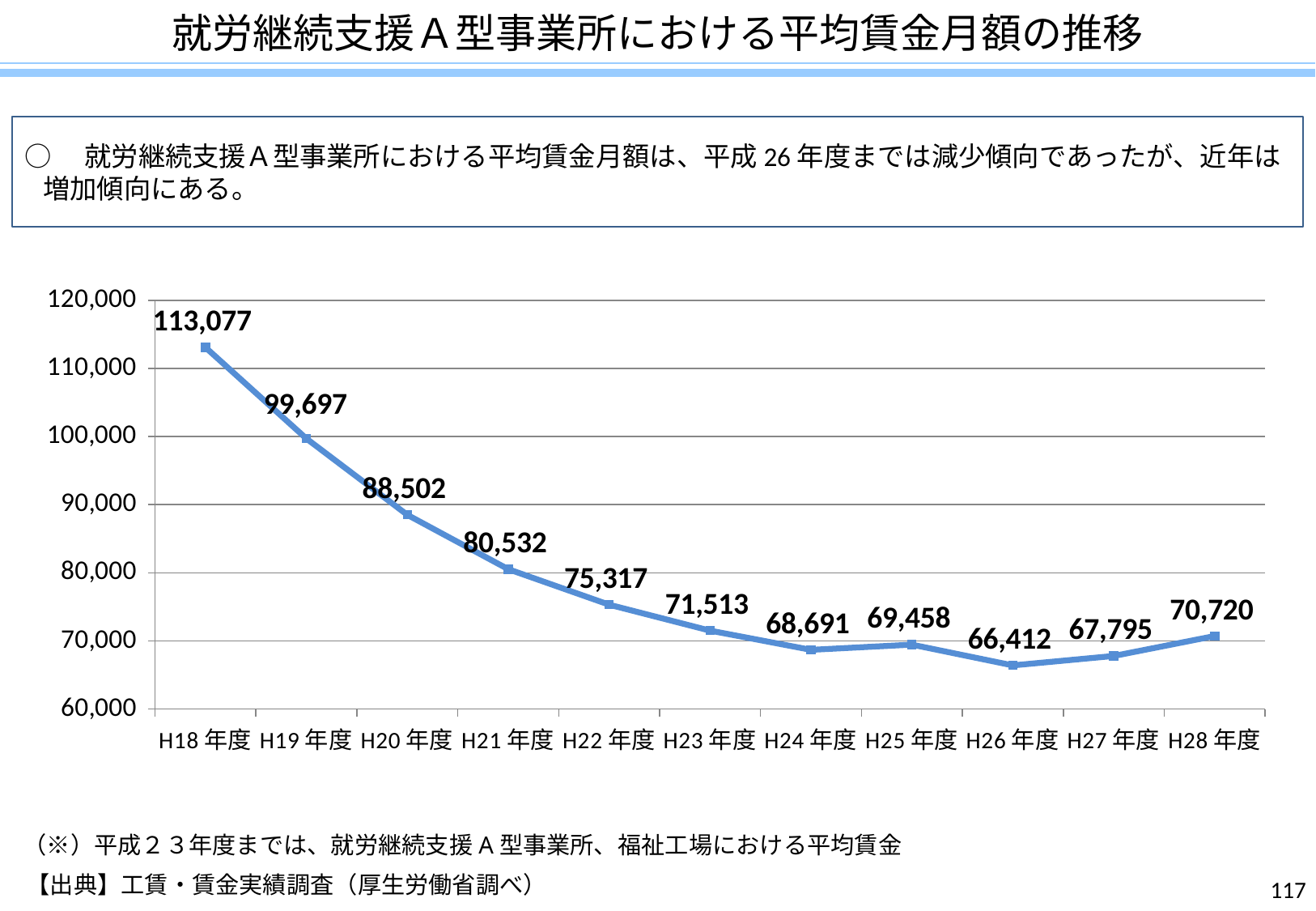
H23年度の値はいくらですか。 71,513 H24年度とH25年度では、どちらの値が大きいですか。 H25年度 平均賃金月額が最も高い年度はどれですか。 H18年度 H18年度の平均賃金月額はいくらですか。 113,077 H28年度の平均賃金月額はいくらですか。 70,720 H27年度とH28年度の値の差はいくらですか。 2,925 グラフには何年度分のデータ点がありますか。 11 H18年度とH28年度の値の差はいくらですか。 42,357 このグラフの種類は何ですか。 折れ線グラフ H20年度の値は90,000より大きいですか、小さいですか。 小さい 平均賃金月額が最も低い年度はどれですか。 H26年度 H18年度からH24年度にかけて、値は増加していますか、減少していますか。 減少